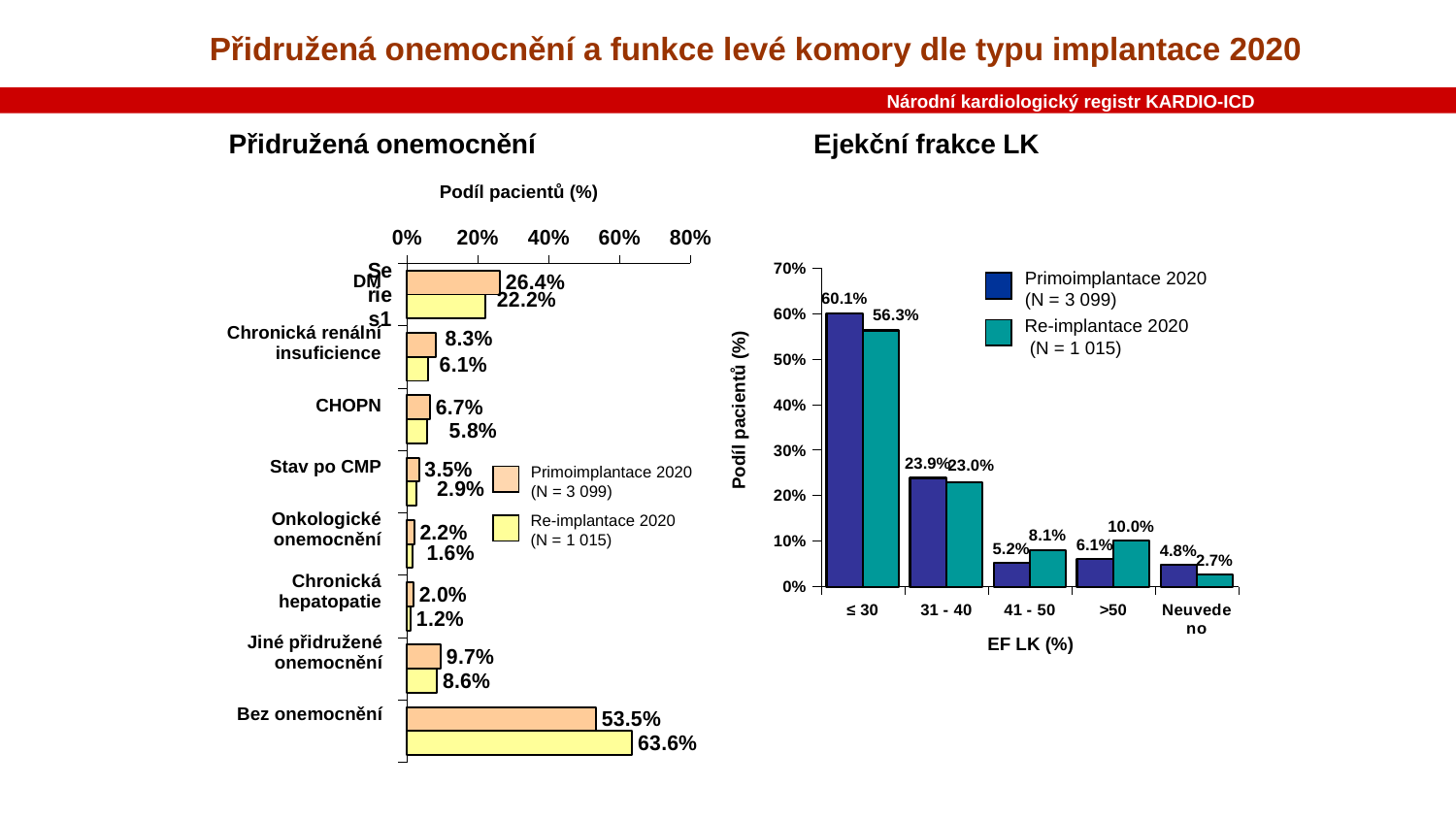
In the 'Přidružená onemocnění' chart, how many categories are shown? 8 In the 'Ejekční frakce LK' chart, what is the value for Re-implantace 2020 in the '>50' category? 10.0% In the 'Ejekční frakce LK' chart, what is the difference between Primoimplantace 2020 and Re-implantace 2020 in the '≤ 30' category? 3.8% In the 'Přidružená onemocnění' chart, what is the value for Primoimplantace 2020 in the 'Bez onemocnění' category? 53.5% In the 'Ejekční frakce LK' chart, what is the value for Primoimplantace 2020 in the '≤ 30' category? 60.1% What kind of chart is the 'Ejekční frakce LK' chart? Bar chart In the 'Přidružená onemocnění' chart, which category has the lowest value for Primoimplantace 2020? Chronická hepatopatie In the 'Přidružená onemocnění' chart, which category has the highest value for Re-implantace 2020? Bez onemocnění In the 'Ejekční frakce LK' chart, how many series does the legend list? 2 In the 'Ejekční frakce LK' chart, which is larger in the '41 - 50' category: Primoimplantace 2020 or Re-implantace 2020? Re-implantace 2020 In the 'Přidružená onemocnění' chart, what is the difference between the Re-implantace 2020 and Primoimplantace 2020 values for 'Bez onemocnění'? 10.1% In the 'Přidružená onemocnění' chart, what is the value for Re-implantace 2020 in the 'CHOPN' category? 5.8%